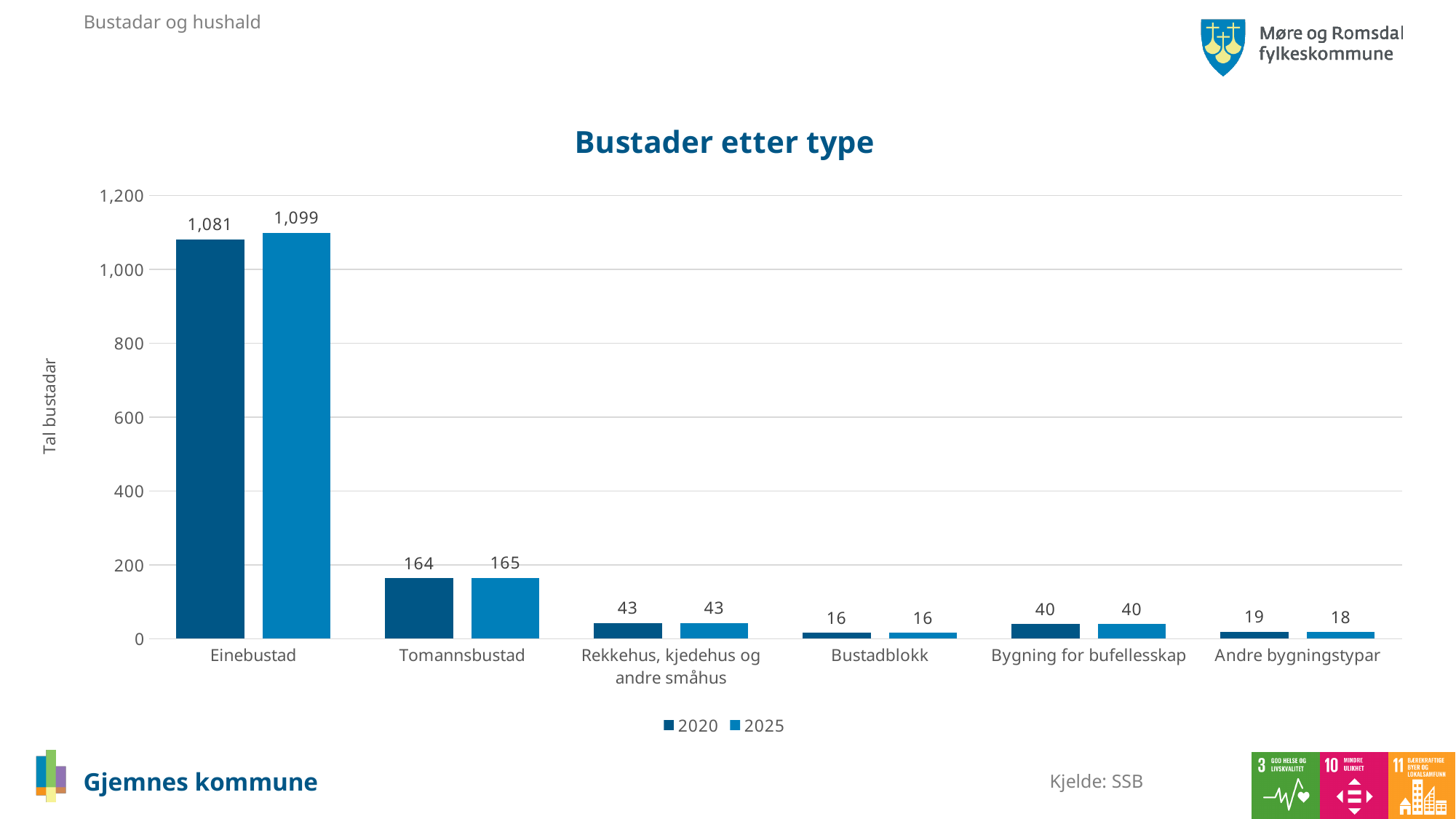
What is the difference between the 2025 and 2020 values for Einebustad? 18 What is the value for Tomannsbustad in 2020? 164 Which category has the lowest value in 2025? Bustadblokk How many series does the legend list? 2 What is the value for Bustadblokk in 2025? 16 What kind of chart is shown? Bar chart Which is larger: the 2020 value for Bygning for bufellesskap or the 2020 value for Rekkehus, kjedehus og andre småhus? Rekkehus, kjedehus og andre småhus What is the value for Andre bygningstypar in 2020? 19 How many categories are shown on the x axis? 6 Which category has the highest value in 2020? Einebustad What is the title of the chart? Bustader etter type What is the value for Einebustad in 2025? 1,099